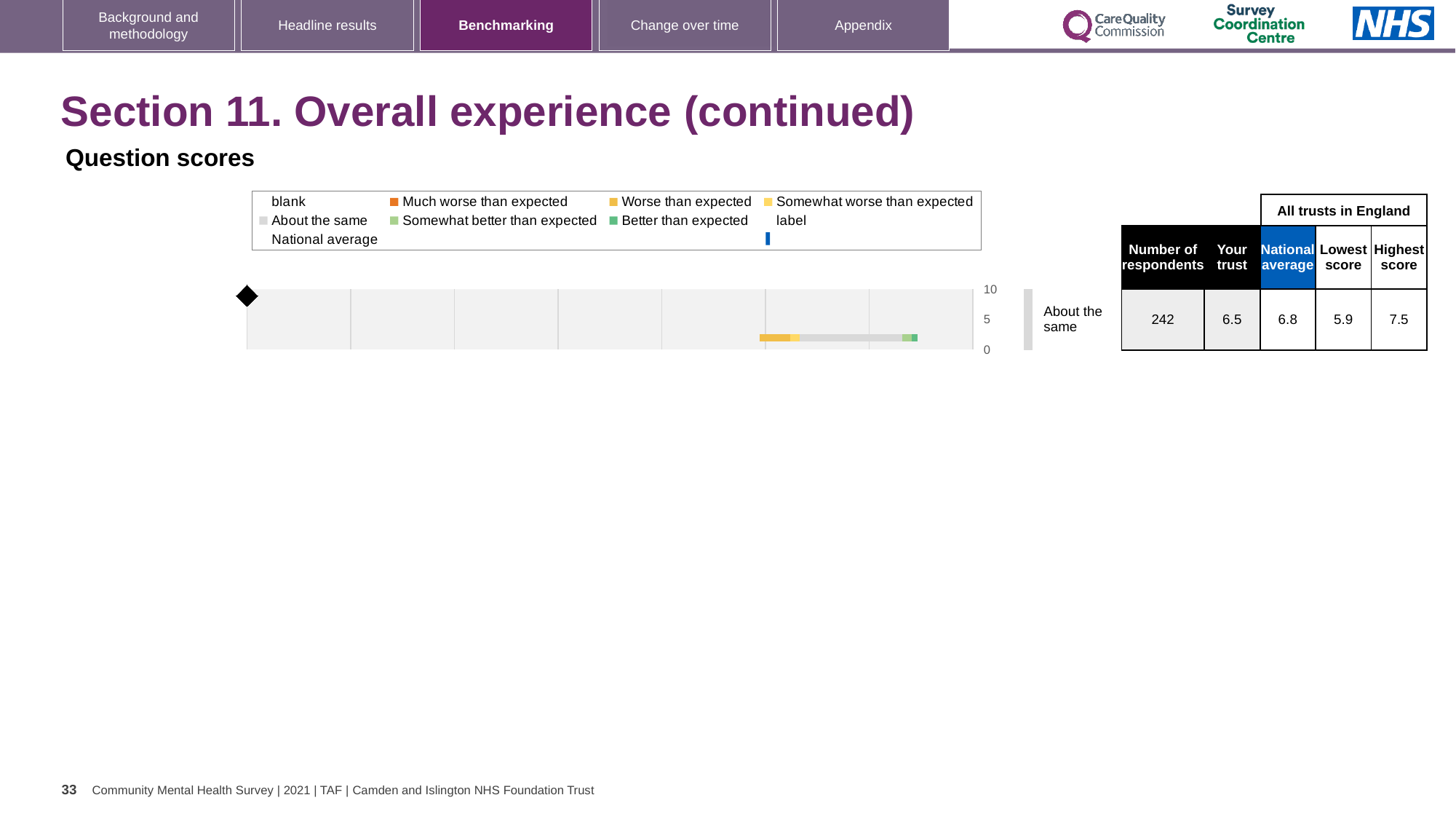
What is the difference between the highest score and the lowest score among all trusts in England for this question? 1.6 Which is larger for this question: the "Your trust" score or the national average? National average How many respondents are shown for the question in the Question scores chart? 242 What is the lowest score among all trusts in England shown for this question? 5.9 What is the highest score among all trusts in England shown for this question? 7.5 What is the maximum value shown on the axis of the Question scores chart? 10 What is the national average score shown for the question in the Question scores chart? 6.8 What benchmark category label is shown next to the bar in the Question scores chart? About the same What is the "Your trust" score shown for the question in the Question scores chart? 6.5 What is the difference between the national average and the "Your trust" score for this question? 0.3 What kind of chart is shown under "Question scores"? bar chart How many question bars are plotted in the Question scores chart? 1